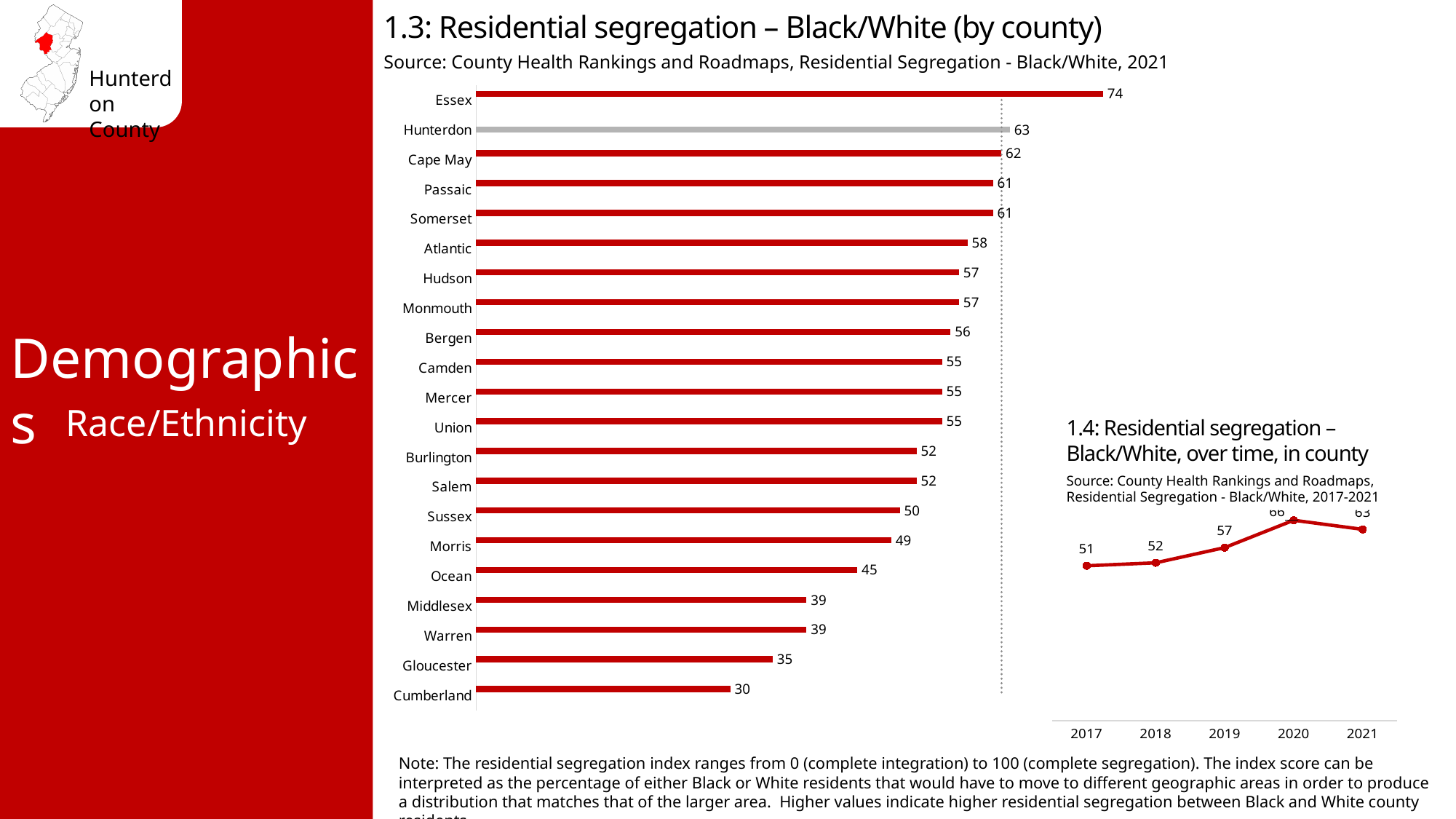
What kind of chart is chart 1.3 (Residential segregation – Black/White by county)? Bar chart In chart 1.3 (by county), what is the difference between the values for Essex and Hunterdon? 11 In chart 1.3 (by county), what is the value for Cumberland? 30 In chart 1.3 (by county), how many counties are shown? 21 In chart 1.4 (over time), what is the value for 2019? 57 In chart 1.3 (by county), which county has the highest value? Essex In chart 1.3 (by county), which county has the lowest value? Cumberland In chart 1.4 (over time), do the values rise or fall from 2017 to 2020? Rise In chart 1.3 (Residential segregation – Black/White by county), what is the value for Hunterdon? 63 In chart 1.3 (by county), what is the value for Gloucester? 35 In chart 1.3 (by county), which has a larger value, Ocean or Morris? Morris In chart 1.4 (Residential segregation – Black/White over time), what is the value for 2017? 51